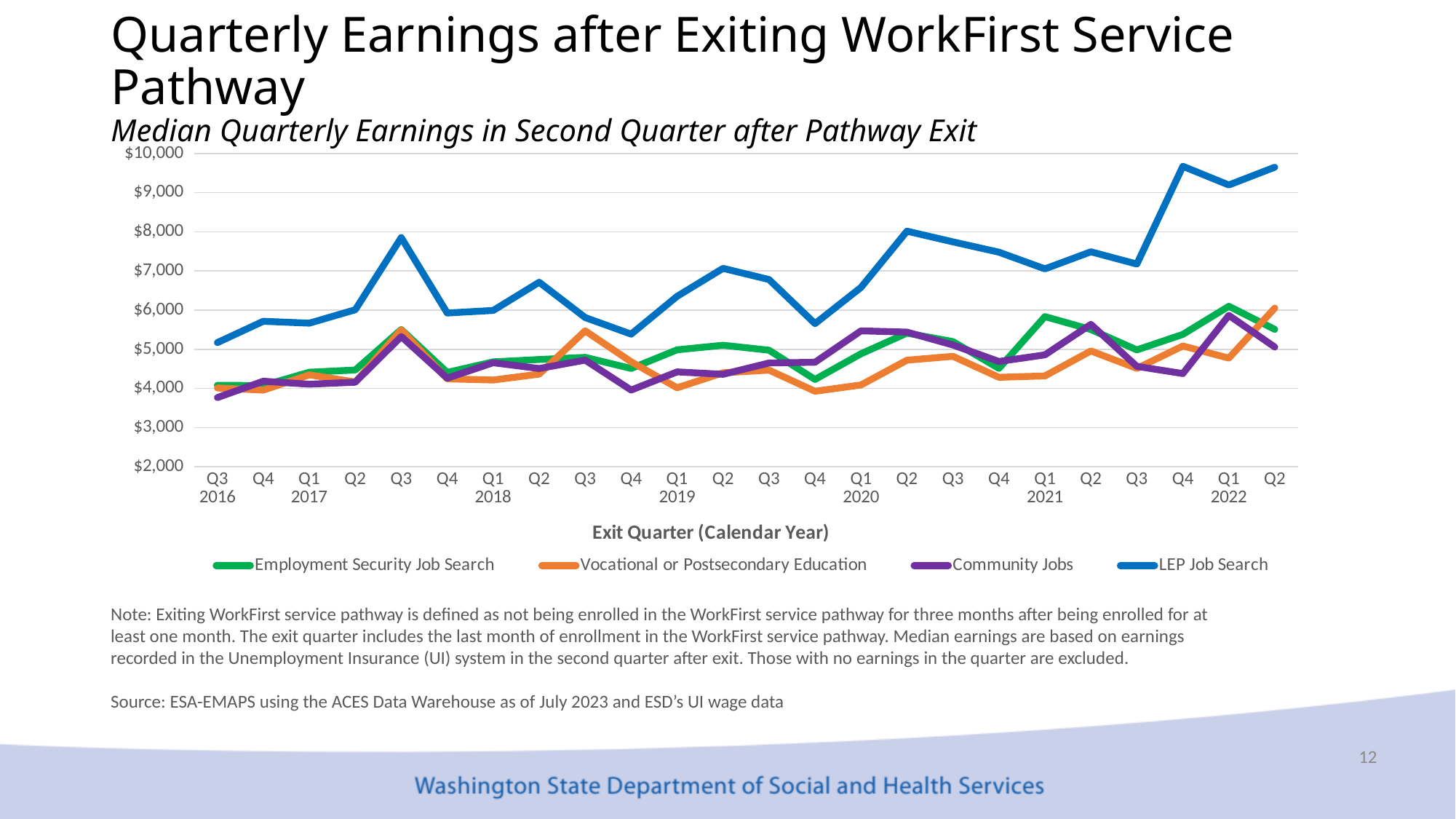
Which series has the lowest value in Q3 2016? Community Jobs How many exit quarters are plotted along the x axis? 24 What kind of chart is shown on the slide? Line chart Does the LEP Job Search line generally rise or fall from Q3 2016 to Q2 2022? rise In Q2 2022, which is larger: LEP Job Search or Community Jobs? LEP Job Search Is the value for LEP Job Search in Q3 2017 greater or less than $7,000? greater Which series has the highest value in Q4 2021? LEP Job Search Is the value for LEP Job Search in Q4 2021 greater or less than $9,000? greater Is the value for Employment Security Job Search in Q1 2021 greater or less than $5,000? greater What is the title of the x axis? Exit Quarter (Calendar Year) How many series does the legend list? 4